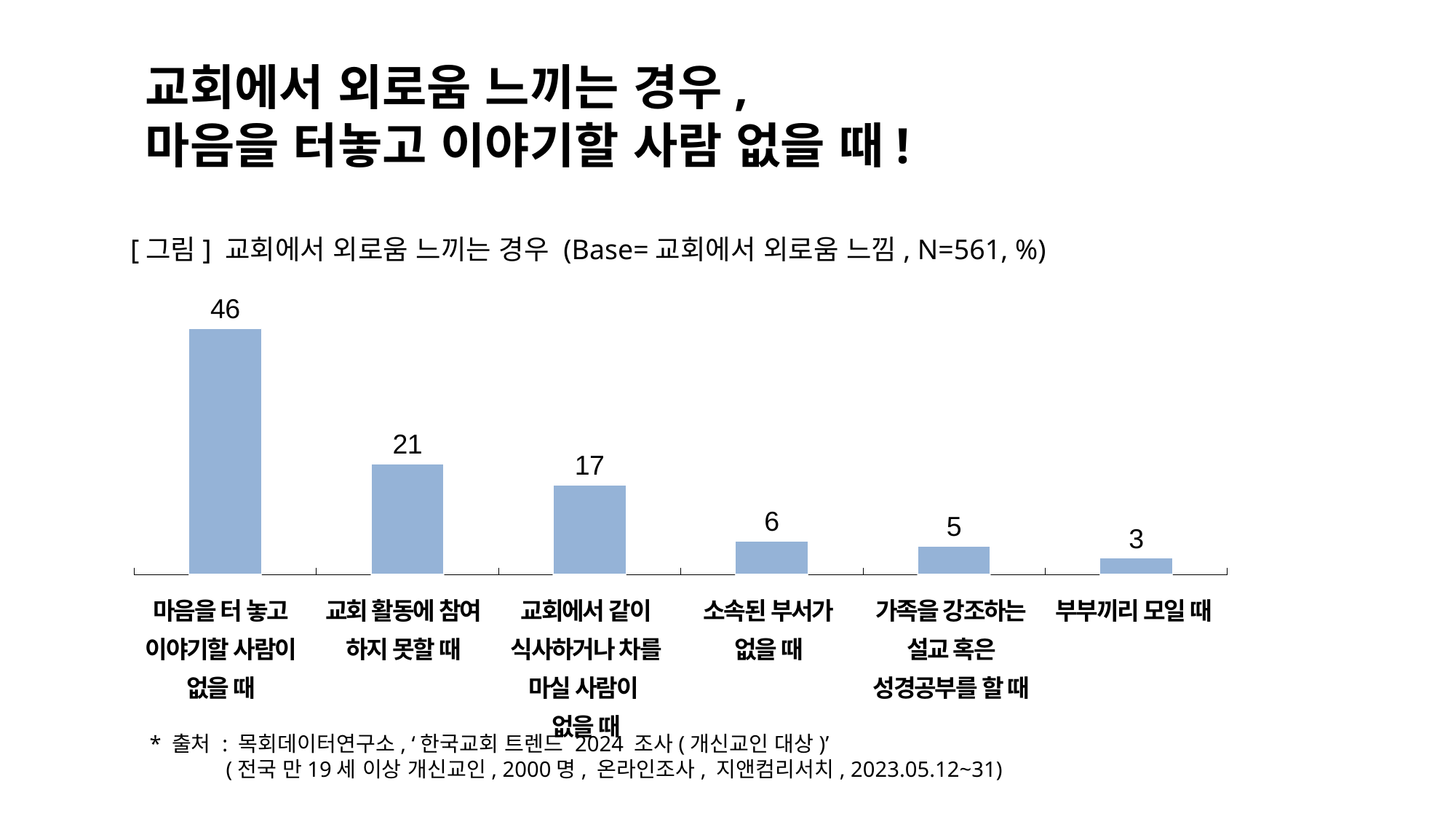
Which is larger: the value for '교회에서 같이 식사하거나 차를 마실 사람이 없을 때' or '가족을 강조하는 설교 혹은 성경공부를 할 때'? 교회에서 같이 식사하거나 차를 마실 사람이 없을 때 What is the difference between the values for '마음을 터 놓고 이야기할 사람이 없을 때' and '교회 활동에 참여하지 못할 때'? 25 What is the value for '소속된 부서가 없을 때'? 6 What is the base size (N) stated in the chart caption? N=561 Which category has the lowest value? 부부끼리 모일 때 Do the values rise or fall from left to right along the x axis? Fall How many categories are shown in the chart? 6 Which category has the highest value? 마음을 터 놓고 이야기할 사람이 없을 때 What is the value for '교회 활동에 참여하지 못할 때'? 21 What kind of chart is shown on the slide? Bar chart What is the value for '부부끼리 모일 때'? 3 What is the value for '마음을 터 놓고 이야기할 사람이 없을 때'? 46